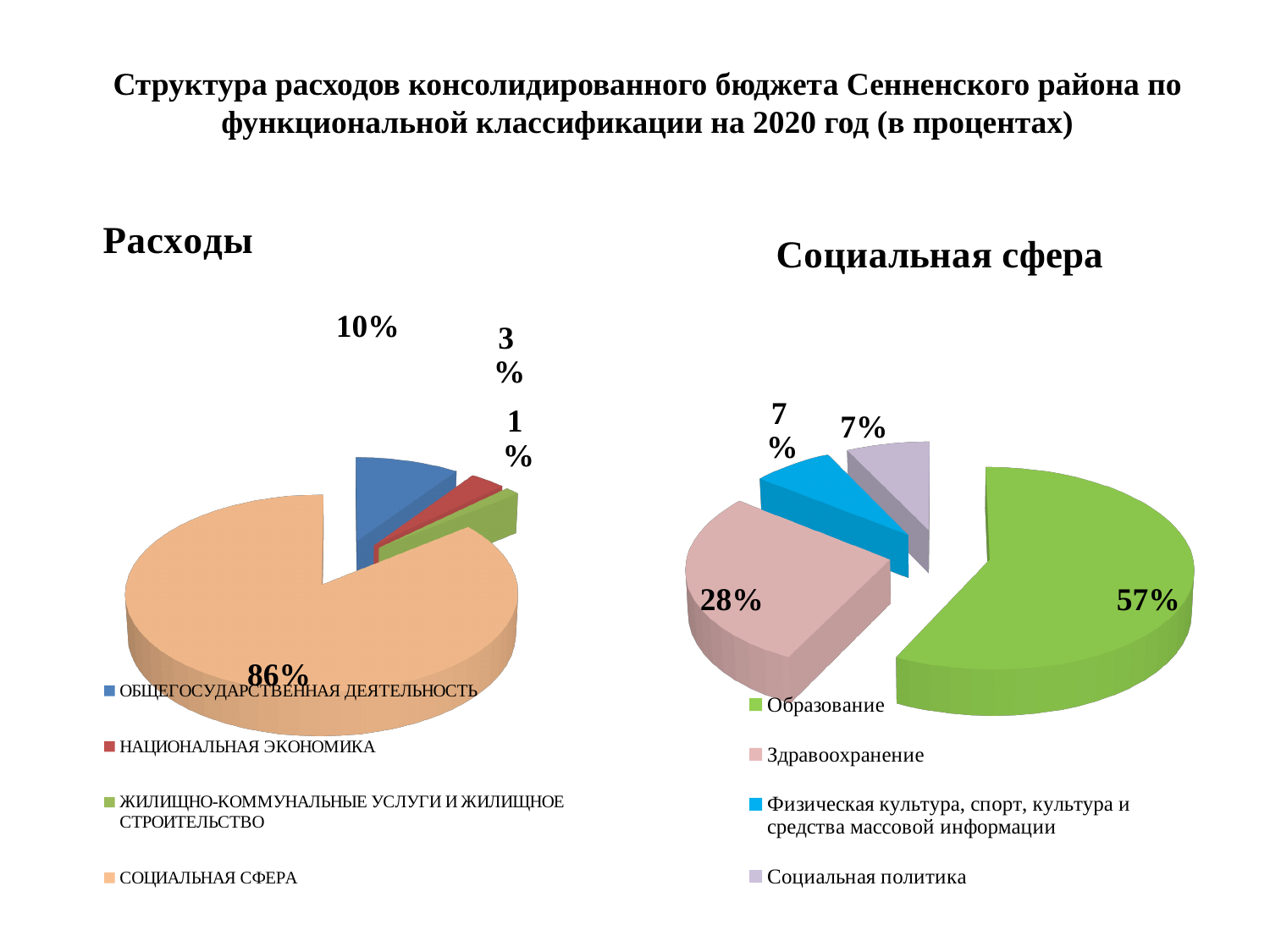
What kind of chart is the "Социальная сфера" chart? Pie chart In the "Социальная сфера" chart, what is the difference between the shares of Образование and Здравоохранение? 29% In the "Социальная сфера" chart, what share is shown for Образование? 57% In the "Социальная сфера" chart, what colour is the Образование slice? Green In the "Расходы" chart, what share is shown for ОБЩЕГОСУДАРСТВЕННАЯ ДЕЯТЕЛЬНОСТЬ? 10% In the "Социальная сфера" chart, what share is shown for Здравоохранение? 28% In the "Расходы" chart, what is the difference between the shares of ОБЩЕГОСУДАРСТВЕННАЯ ДЕЯТЕЛЬНОСТЬ and НАЦИОНАЛЬНАЯ ЭКОНОМИКА? 7% In the "Расходы" chart, what share is shown for СОЦИАЛЬНАЯ СФЕРА? 86% In the "Расходы" chart, which category has the smallest share? ЖИЛИЩНО-КОММУНАЛЬНЫЕ УСЛУГИ И ЖИЛИЩНОЕ СТРОИТЕЛЬСТВО In the "Социальная сфера" chart, which is larger: Образование or Здравоохранение? Образование How many categories does the legend of the "Расходы" chart list? 4 In the "Расходы" chart, which category has the largest share? СОЦИАЛЬНАЯ СФЕРА